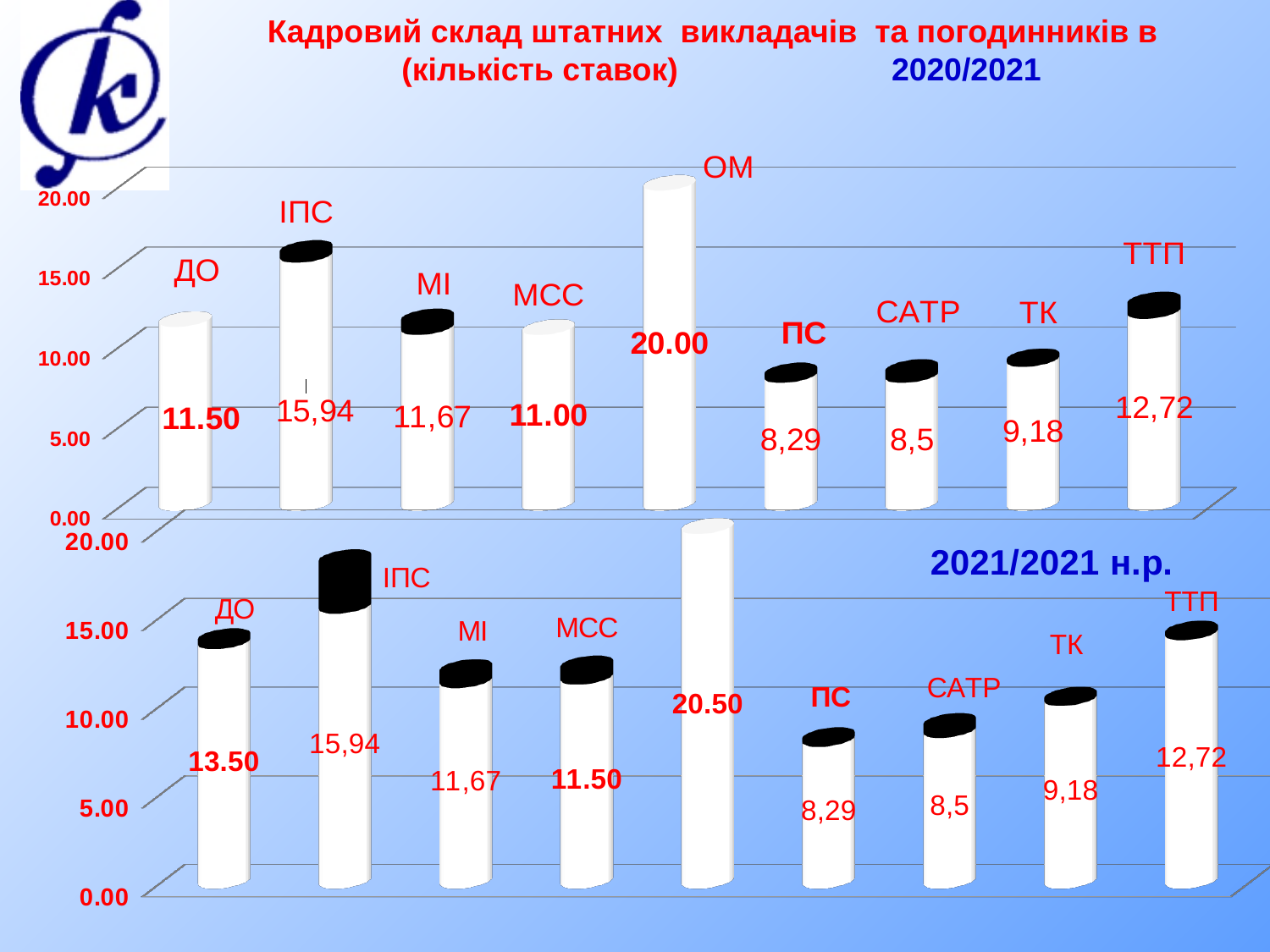
In the bottom chart (2021/2021 н.р.), what is the value for ТТП? 12,72 How many categories are plotted in the top chart (2020/2021)? 9 In the top chart (2020/2021), is the value for ІПС greater or less than 15.00? greater In the bottom chart (2021/2021 н.р.), what is the value for МСС? 11.50 In the top chart (2020/2021), which is larger, the value for ТК or the value for САТР? ТК In the top chart (2020/2021), what is the value for ДО? 11.50 In the top chart (2020/2021), which category has the lowest value? ПС In the top chart (2020/2021), what is the difference between the values for ОМ and ДО? 8.50 What type of chart is used on this slide? Bar chart In the bottom chart (2021/2021 н.р.), which category has the lowest value? ПС In the bottom chart (2021/2021 н.р.), what is the value for ДО? 13.50 In the top chart (2020/2021), which category has the highest value? ОМ